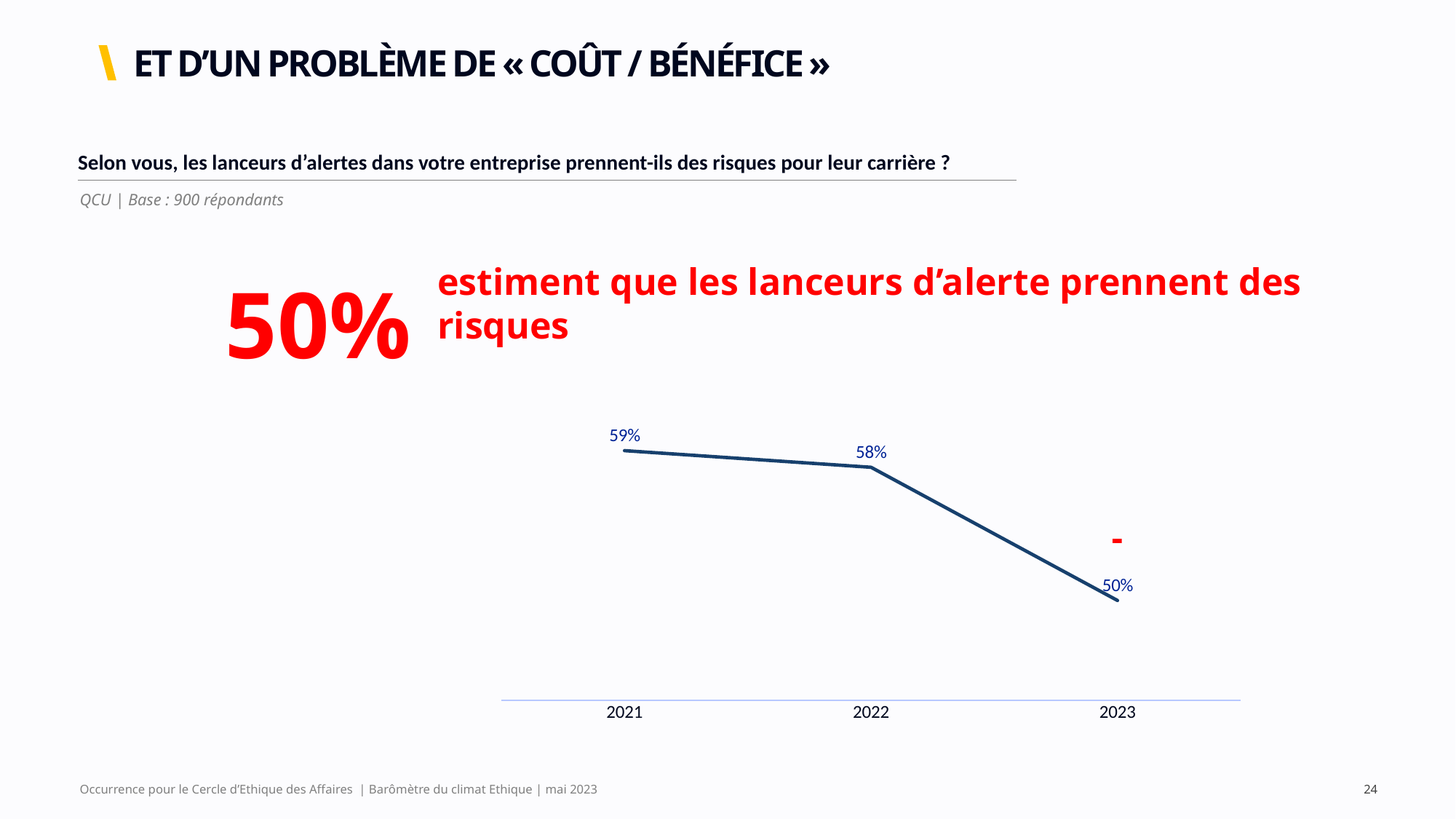
What kind of chart is shown on the slide? Line chart How many data points are plotted on the chart? 3 Which year has the highest value? 2021 What is the value for 2021? 59% Which is larger, the value for 2021 or the value for 2023? 2021 What is the value for 2022? 58% What is the difference between the values for 2022 and 2023? 8 percentage points Which year has the lowest value? 2023 What is the value for 2023? 50% Do the values rise or fall from 2021 to 2023? Fall What is the difference between the values for 2021 and 2023? 9 percentage points What is the base (number of respondents) stated for the chart? 900 répondants